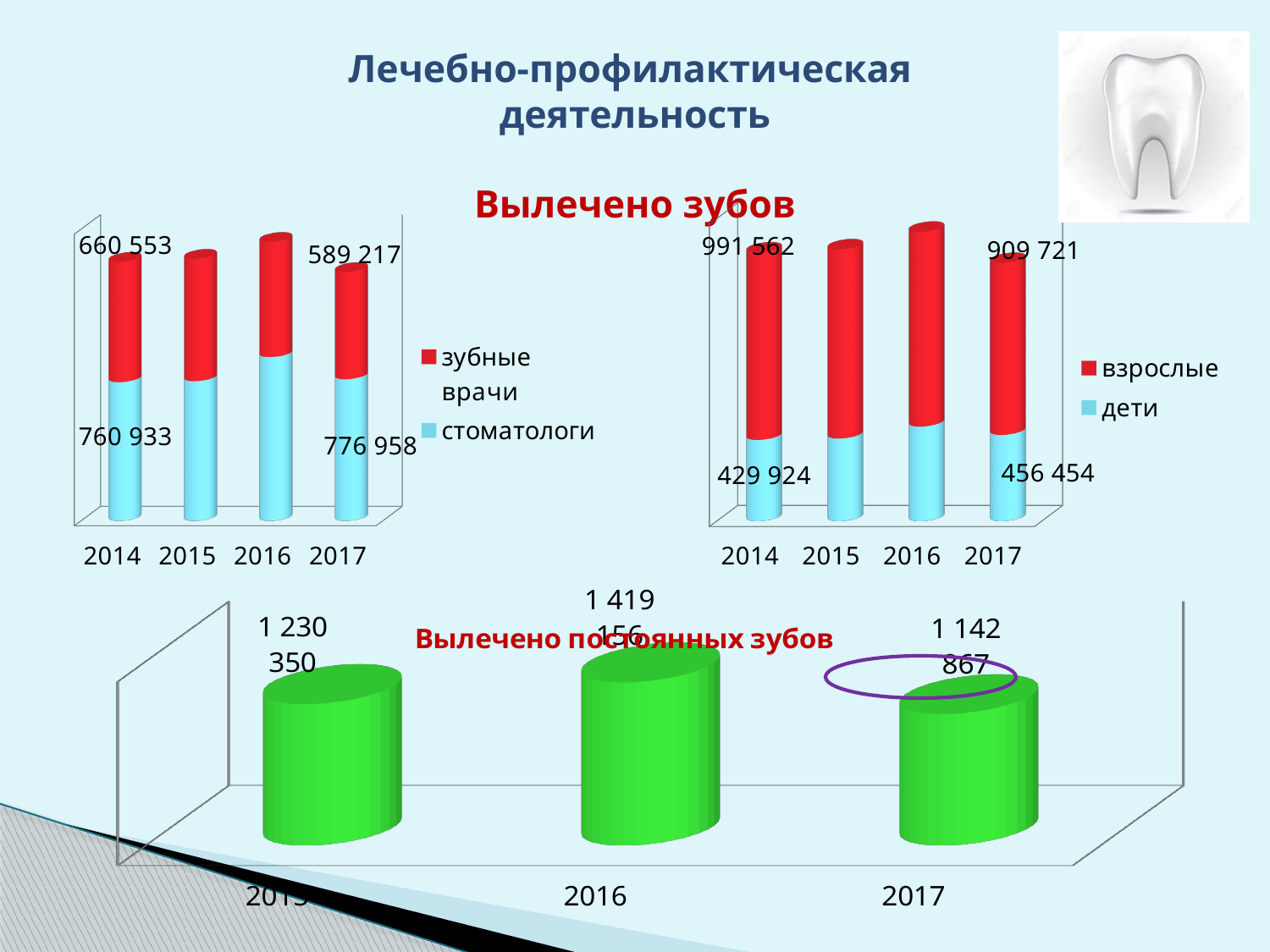
In the bottom chart 'Вылечено постоянных зубов', which year has the highest value? 2016 In the top-right chart (legend: взрослые, дети), what is the value for дети in 2017? 456 454 In the top-right chart (legend: взрослые, дети), what is the difference between the взрослые and дети values in 2017? 453 267 In the top-right chart (legend: взрослые, дети), what is the value for взрослые in 2014? 991 562 In the bottom chart 'Вылечено постоянных зубов', what is the difference between the 2016 and 2017 values? 276 289 In the top-left chart (legend: зубные врачи, стоматологи), by how much does the зубные врачи value in 2014 exceed the зубные врачи value in 2017? 71 336 In the top-left chart (legend: зубные врачи, стоматологи), what is the value for зубные врачи in 2014? 660 553 What kind of chart is the bottom chart 'Вылечено постоянных зубов'? bar chart In the top-left chart (legend: зубные врачи, стоматологи), what is the total of the stacked bar for 2014? 1 421 486 In the bottom chart 'Вылечено постоянных зубов', how many years are shown? 3 How many series does the legend of the top-right chart list? 2 In the top-left chart (legend: зубные врачи, стоматологи), what is the value for стоматологи in 2017? 776 958